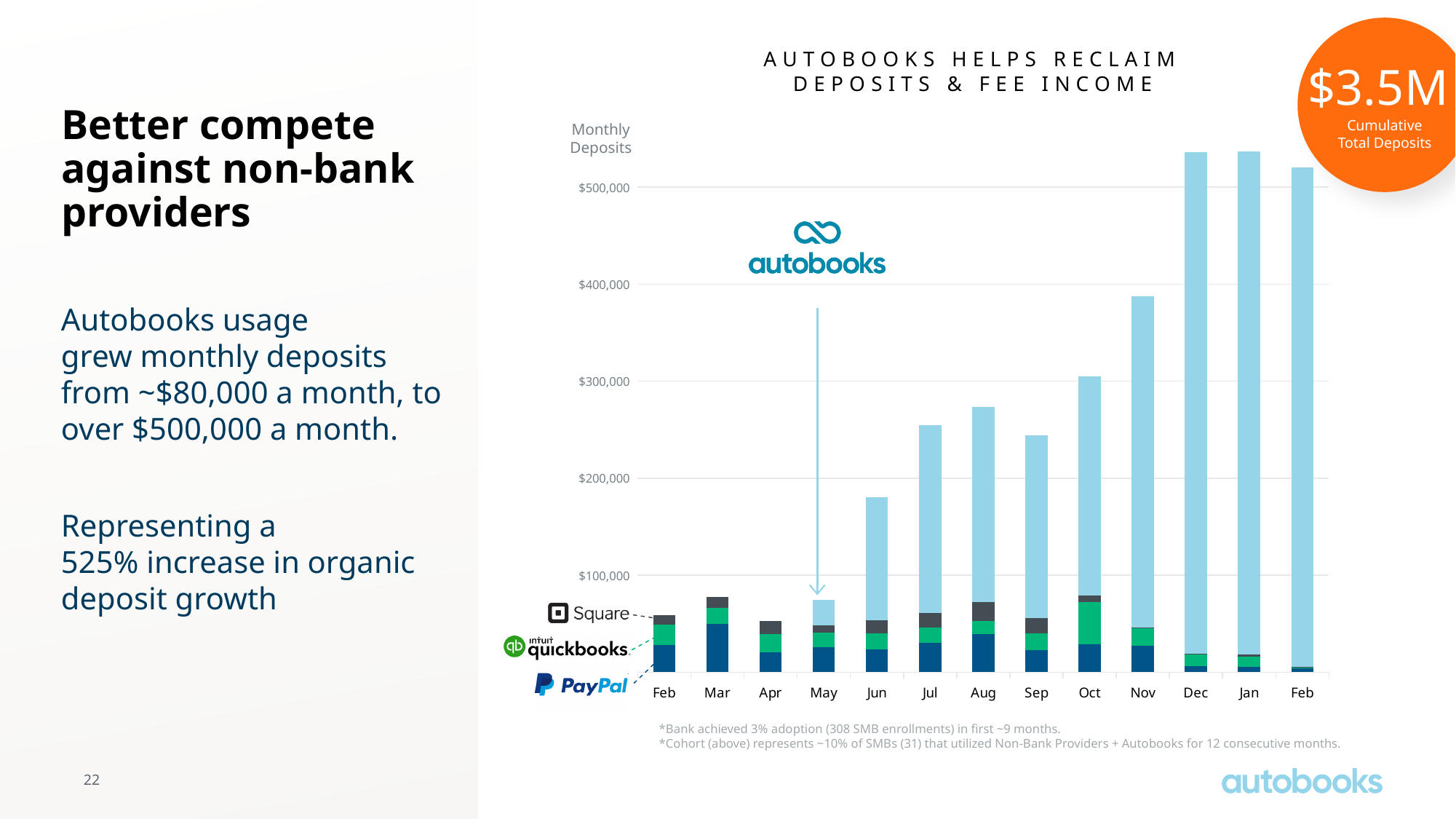
Is the total monthly deposits value for Dec greater or less than $500,000? greater Is the total monthly deposits value for Apr greater or less than $100,000? less Which month has the larger total monthly deposits, Mar or Apr? Mar Which month has the larger total monthly deposits, Aug or Sep? Aug Is the total monthly deposits value for Jun greater or less than $200,000? less What kind of chart is shown on the slide? Stacked bar chart How many months are plotted along the x axis of the chart? 13 Which three non-bank providers are labeled next to the bar segments in the chart? Square, QuickBooks, PayPal Do total monthly deposits generally rise or fall from the first Feb to the last Feb on the x axis? Rise What is the title of the chart? AUTOBOOKS HELPS RECLAIM DEPOSITS & FEE INCOME